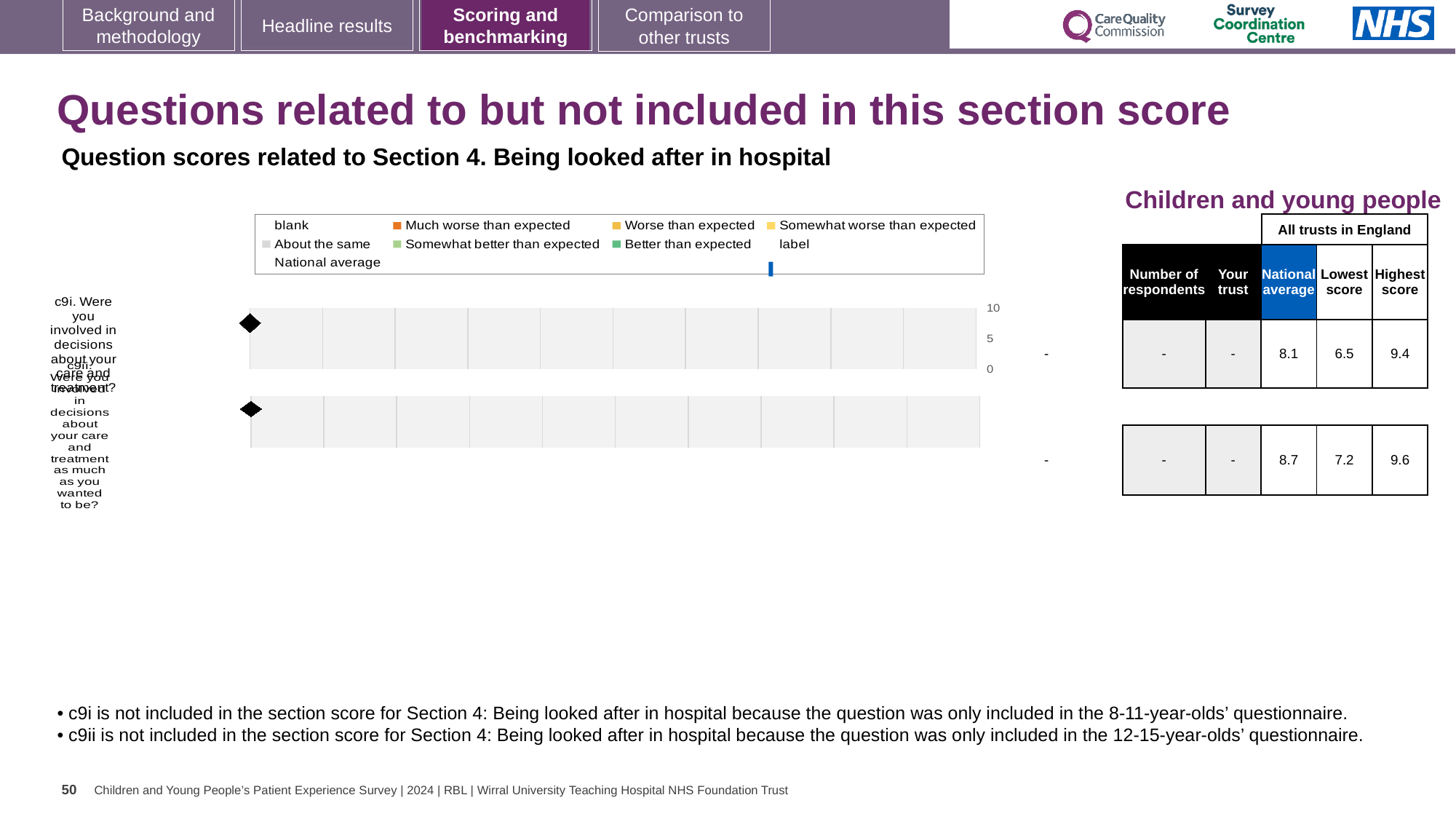
What is the difference between the national average scores for c9ii and c9i in the table? 0.6 What is the largest value shown on the chart's numeric axis? 10 What kind of chart is shown on the slide? bar chart In the table, what is the national average score for c9ii? 8.7 How many question categories are plotted on the chart? 2 What colour is the legend marker for 'Much worse than expected'? orange In the table, what is the lowest score for c9i? 6.5 What is shown in the 'Your trust' column for c9i in the table? - Which question has the higher national average in the table, c9i or c9ii? c9ii In the table, what is the national average score for c9i? 8.1 In the table, what is the highest score for c9ii? 9.6 Which question has the higher 'Lowest score' in the table, c9i or c9ii? c9ii